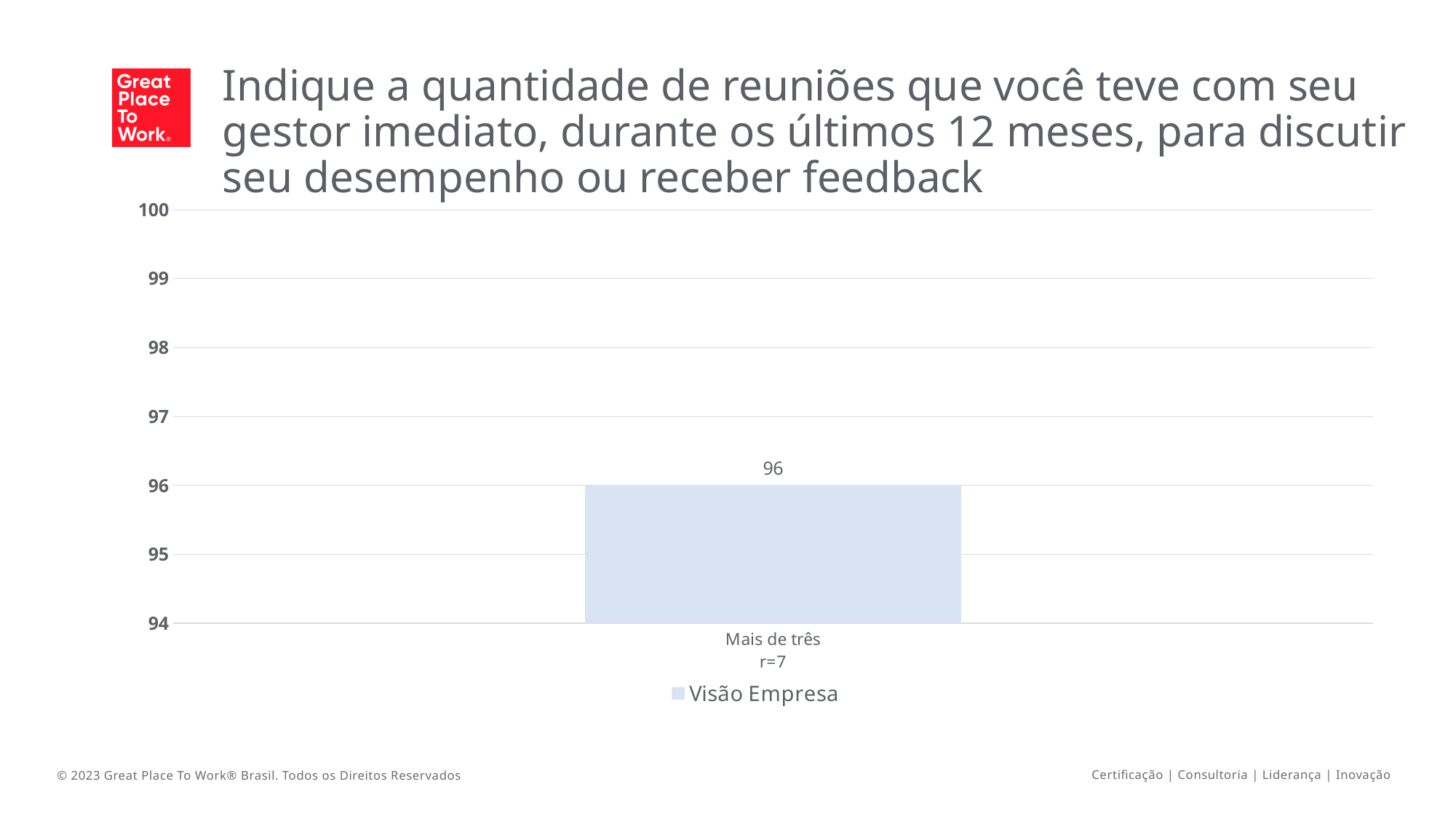
Is the value for "Mais de três" greater or less than 98? less What series name is shown in the legend? Visão Empresa Is the value for "Mais de três" greater or less than 95? greater What kind of chart is shown on the slide? bar chart What is the label of the only category on the x axis? Mais de três How many series does the legend list? 1 What is the lowest value shown on the vertical axis? 94 What is the highest value shown on the vertical axis? 100 What is the value for the category "Mais de três"? 96 How many categories are plotted on the chart? 1